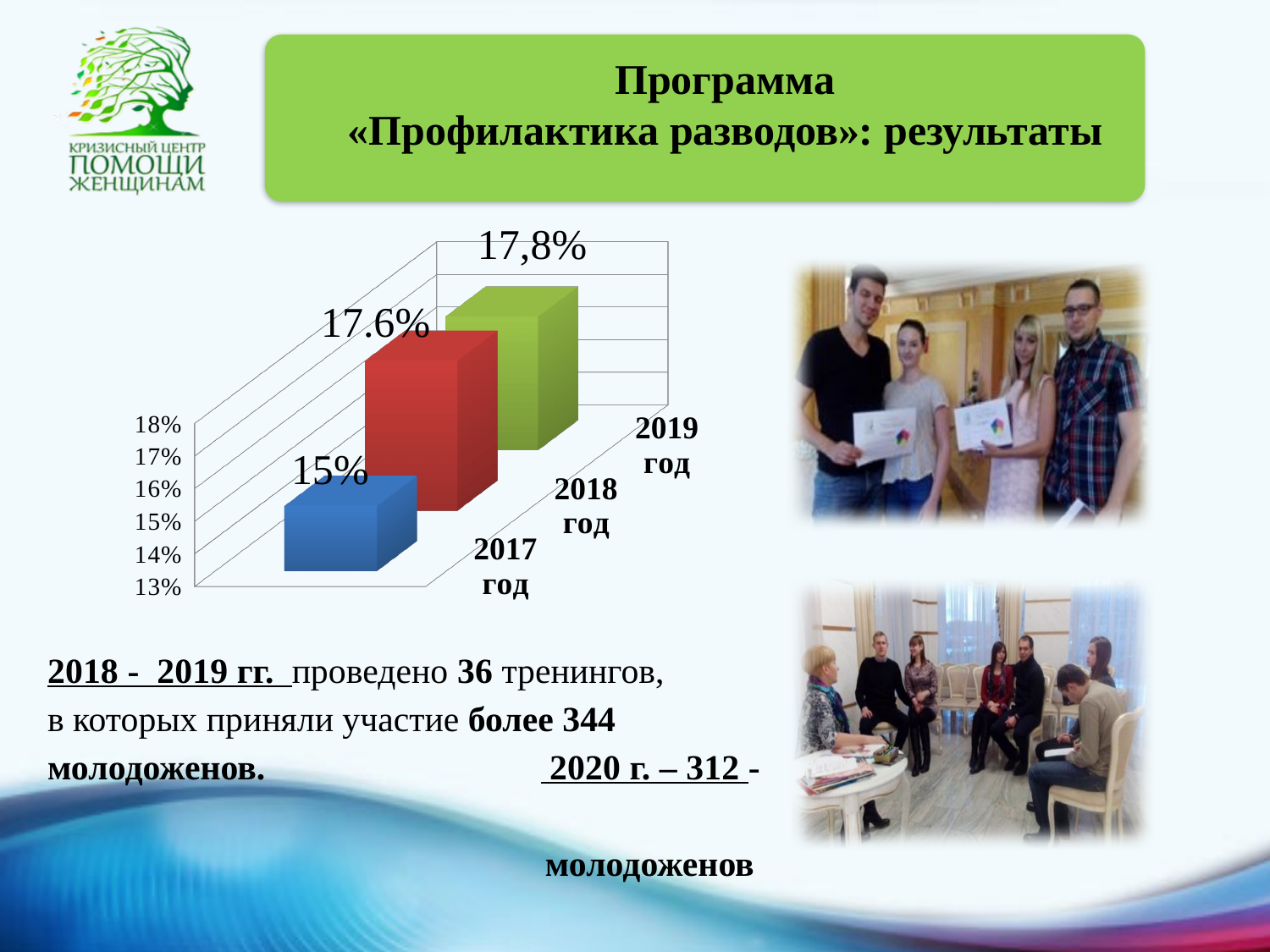
What value is shown for 2017 год? 15% What value is shown for 2019 год? 17,8% What value is shown for 2018 год? 17.6% What is the difference between the values for 2018 год and 2017 год? 2.6 percentage points Which is larger, the value for 2018 год or the value for 2017 год? 2018 год How many years (bars) are shown in the chart? 3 Is the value for 2017 год greater or less than 16%? less Do the values rise or fall from 2017 год to 2019 год? rise Which year has the highest value in the chart? 2019 год Which year has the lowest value in the chart? 2017 год What kind of chart is shown on the slide? bar chart What is the difference between the values for 2019 год and 2017 год? 2.8 percentage points